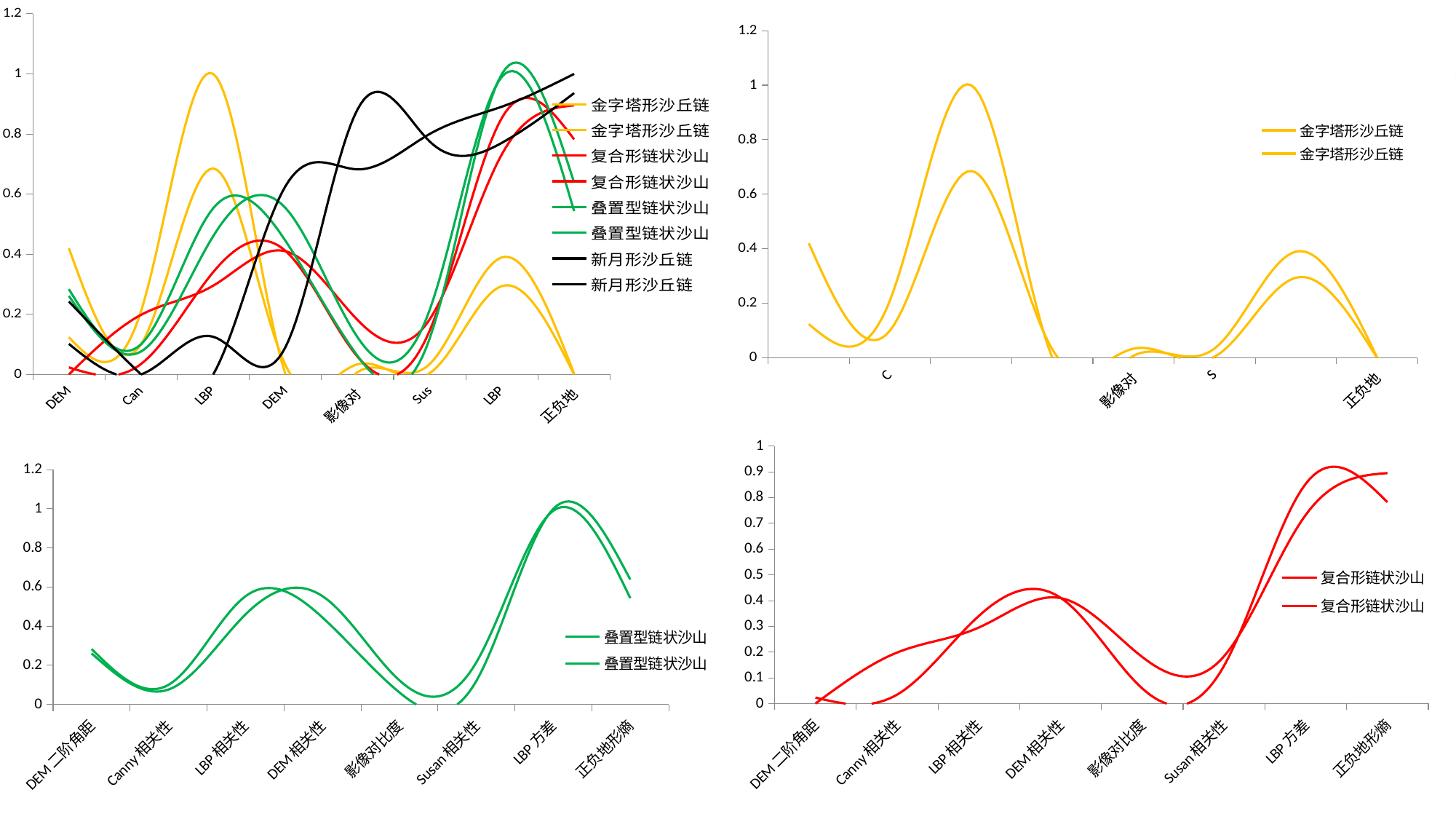
In the bottom-right chart, is the value at DEM 相关性 greater or less than 0.3? greater In the bottom-left chart, at which category do the lines reach their highest value? LBP 方差 How many series does the legend of the top-left chart list? 8 In the bottom-left chart, which is larger, the value at LBP 方差 or the value at Canny 相关性? LBP 方差 How many series does the legend of the bottom-right chart list? 2 How many categories are on the x axis of the bottom-left chart? 8 What series name appears in the legend of the top-right chart? 金字塔形沙丘链 What kind of chart is the bottom-left chart? line chart In the bottom-left chart, is the value at LBP 方差 greater or less than 0.8? greater In the bottom-right chart, do the lines rise or fall from Susan 相关性 to LBP 方差? rise In the bottom-left chart, is the value at Canny 相关性 greater or less than 0.2? less